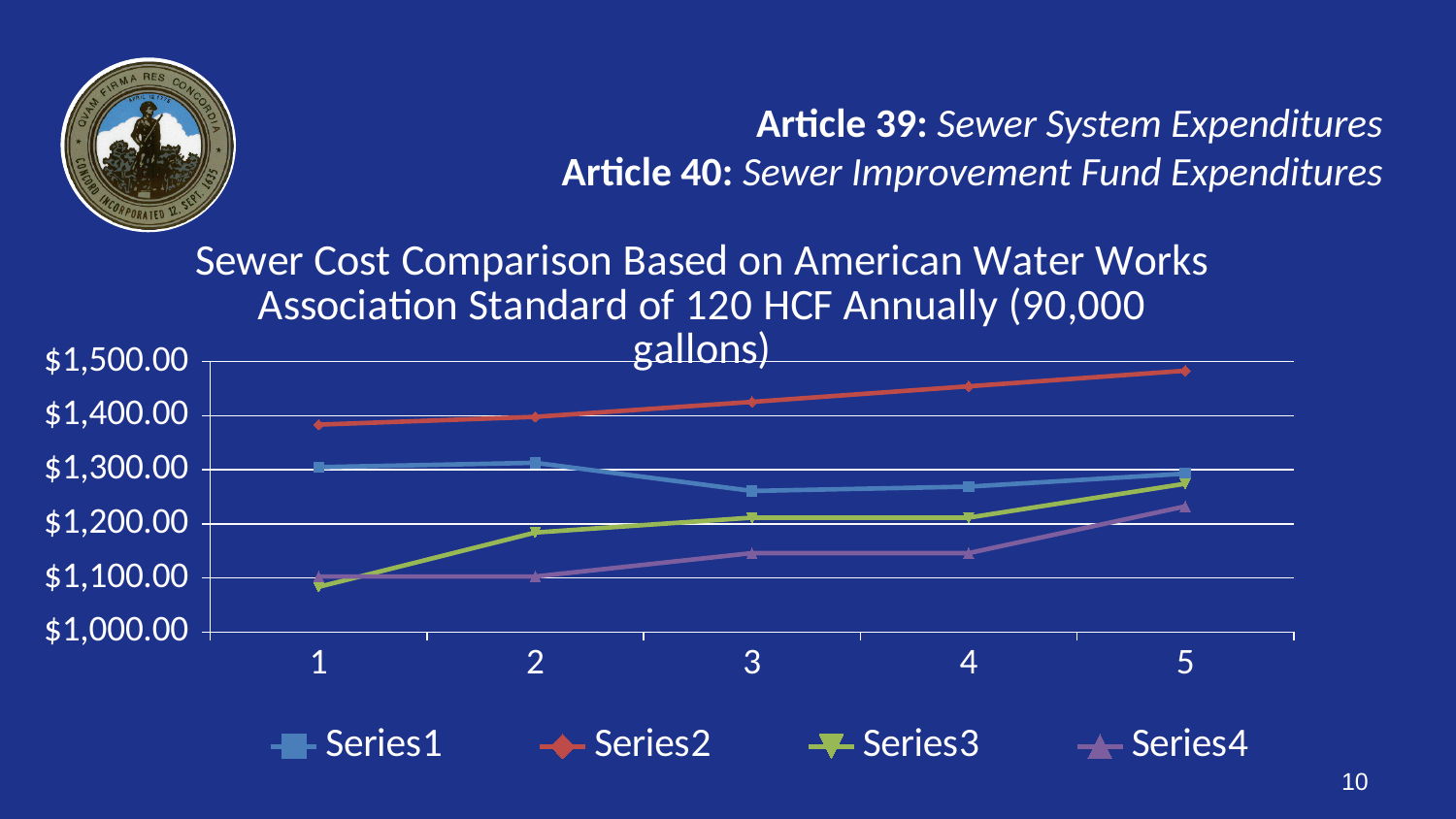
Which series has the lowest value at point 5? Series4 How many series does the legend list? 4 Is the value for Series2 at point 1 greater or less than $1,400.00? less At point 2, which is larger: Series3 or Series4? Series3 What kind of chart is shown on the slide? Line chart Is the value for Series2 at point 5 greater or less than $1,500.00? less Does Series2 rise or fall from point 1 to point 5? Rises How many points are plotted along the x axis for each series? 5 What is the title of the chart? Sewer Cost Comparison Based on American Water Works Association Standard of 120 HCF Annually (90,000 gallons) Which series has the highest value at point 5? Series2 Is the value for Series4 at point 5 greater or less than $1,200.00? greater